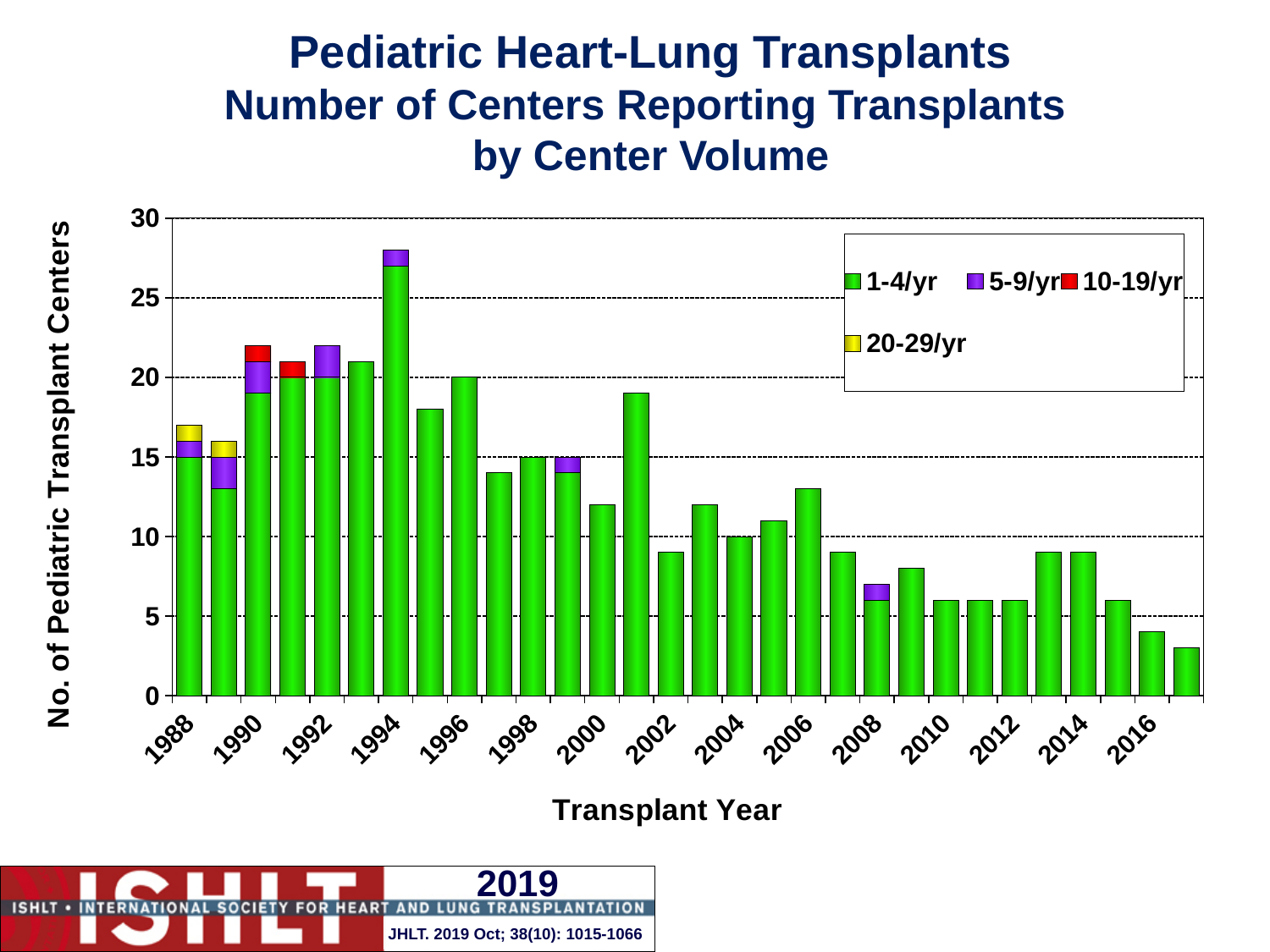
How many series does the legend list? 4 Which year has more reporting centers in total, 2006 or 2010? 2006 Which transplant year has the highest total number of pediatric transplant centers? 1994 Which center-volume series is shown in yellow in the legend? 20-29/yr Is the total number of centers for 2001 greater or less than 15? greater Overall, do the total numbers of reporting centers rise or fall from 1994 to 2017? fall Which transplant year has the lowest total number of pediatric transplant centers? 2017 Which year has more reporting centers in total, 1994 or 2001? 1994 Is the total number of centers for 1994 greater or less than 25? greater What kind of chart is shown on the slide? Stacked bar chart Is the total number of centers for 2017 greater or less than 5? less How many transplant years (bars) are plotted on the chart? 30